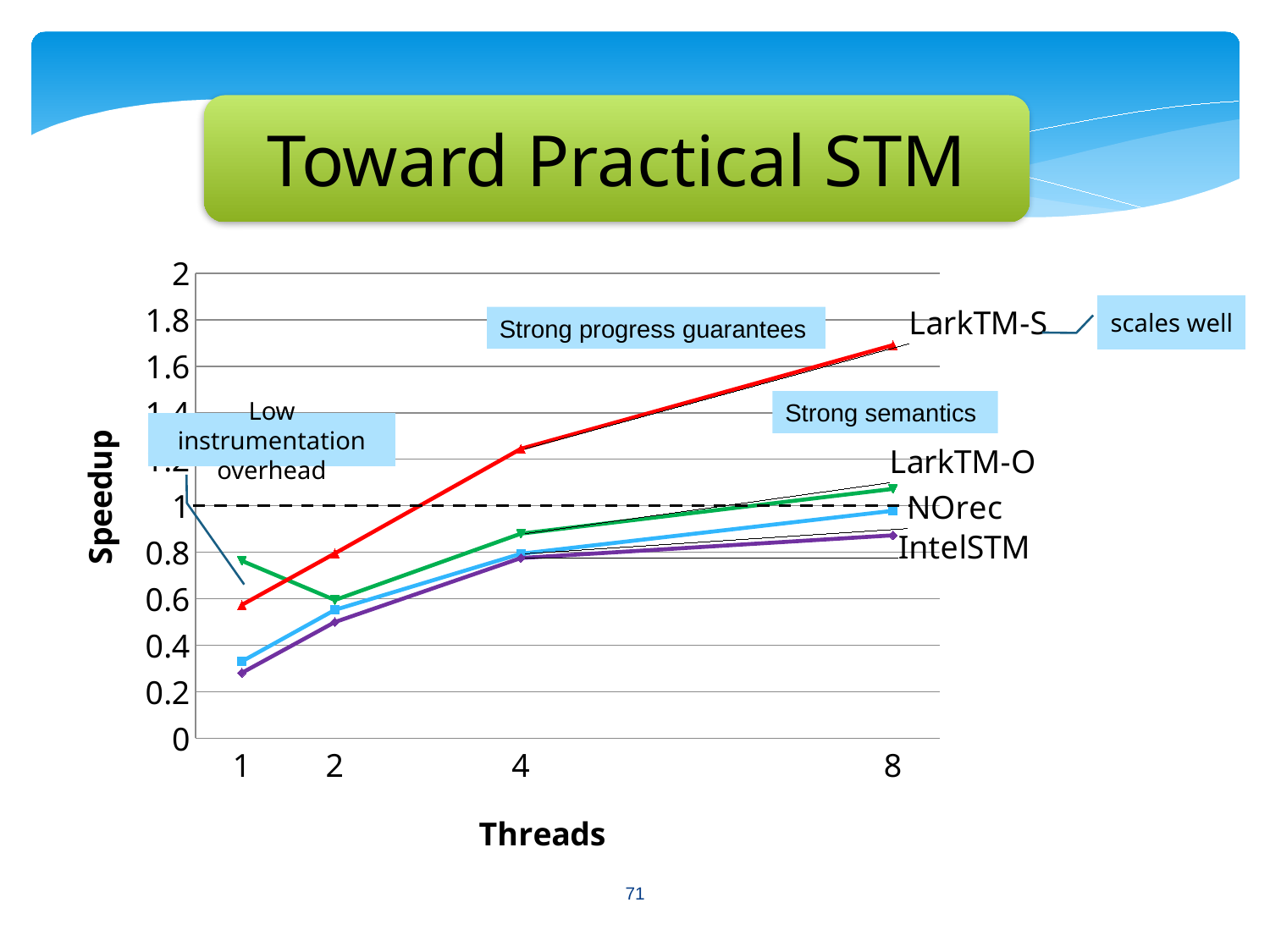
Is the speedup for IntelSTM at 1 thread greater or less than 0.4? less What kind of chart is shown on the slide? line chart Which series has the lowest speedup at 8 threads? IntelSTM Is the speedup for LarkTM-S at 8 threads greater or less than 1.6? greater How many series are plotted in the chart? 4 How many thread counts are plotted along the x axis? 4 At 1 thread, which has the higher speedup, LarkTM-O or LarkTM-S? LarkTM-O Does the speedup for LarkTM-S rise or fall as the number of threads increases? rise Which series has the highest speedup at 8 threads? LarkTM-S Is the speedup for LarkTM-S at 4 threads greater or less than 1? greater What is the label of the y axis? Speedup Which series has the highest speedup at 1 thread? LarkTM-O